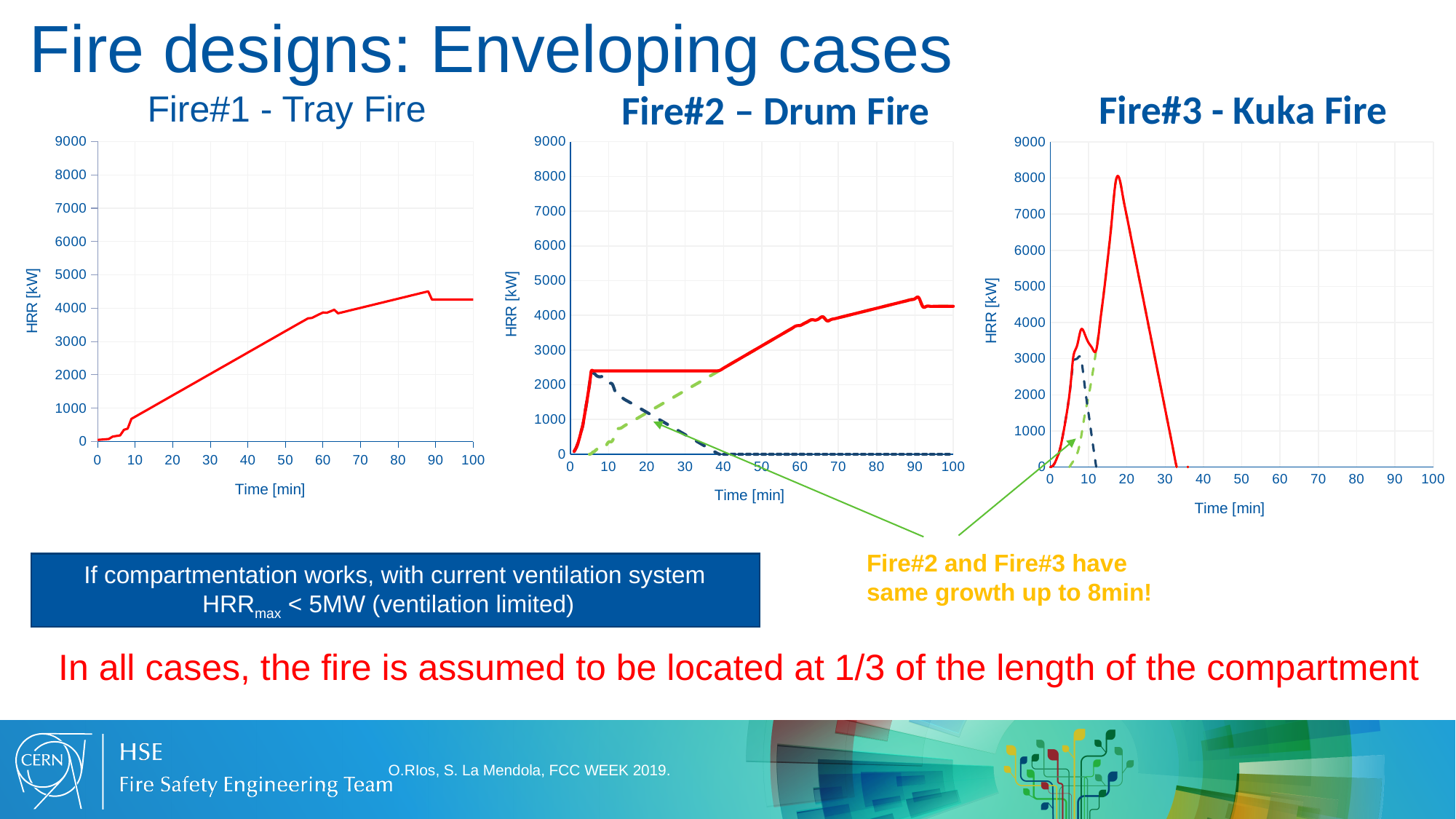
In the 'Fire#3 - Kuka Fire' chart, does the HRR rise or fall between 20 and 30 min? fall What is the y-axis label on the 'Fire#2 – Drum Fire' chart? HRR [kW] In the 'Fire#2 – Drum Fire' chart, is the HRR value of the red line at 100 min greater or less than 5000? less What kind of chart is 'Fire#1 - Tray Fire'? line chart In the 'Fire#2 – Drum Fire' chart, is the HRR value of the red line at 20 min greater or less than 3000? less Which chart reaches the higher peak HRR, 'Fire#1 - Tray Fire' or 'Fire#3 - Kuka Fire'? Fire#3 - Kuka Fire In the 'Fire#1 - Tray Fire' chart, does the HRR rise or fall between 0 and 80 min? rise How many charts are shown on the slide? 3 In the 'Fire#1 - Tray Fire' chart, is the HRR value at 100 min greater or less than 5000? less What is the x-axis label on the 'Fire#1 - Tray Fire' chart? Time [min]